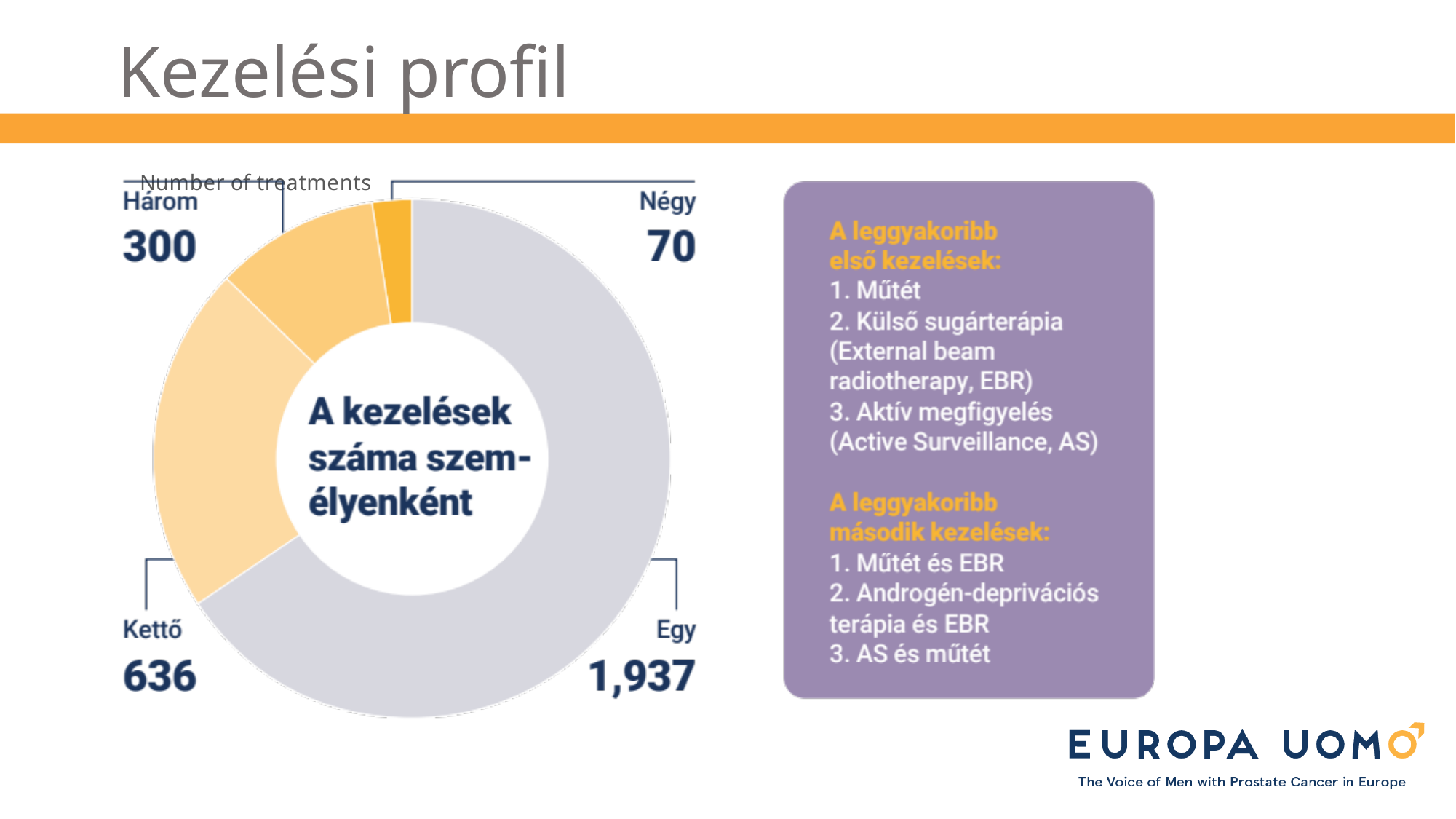
Which is larger, the value for "Kettő" or the value for "Három"? Kettő Which segment of the chart has the lowest value? Négy What is the difference between the values for "Három" and "Négy"? 230 What is the value for the "Egy" segment of the chart? 1,937 What kind of chart is shown on the slide? Pie chart (donut) Which segment of the chart has the highest value? Egy How many segments does the chart have? 4 What is the difference between the values for "Egy" and "Kettő"? 1,301 What is the value for the "Négy" segment of the chart? 70 What is the value for the "Kettő" segment of the chart? 636 What is the value for the "Három" segment of the chart? 300 What text is written in the centre of the donut chart? A kezelések száma személyenként